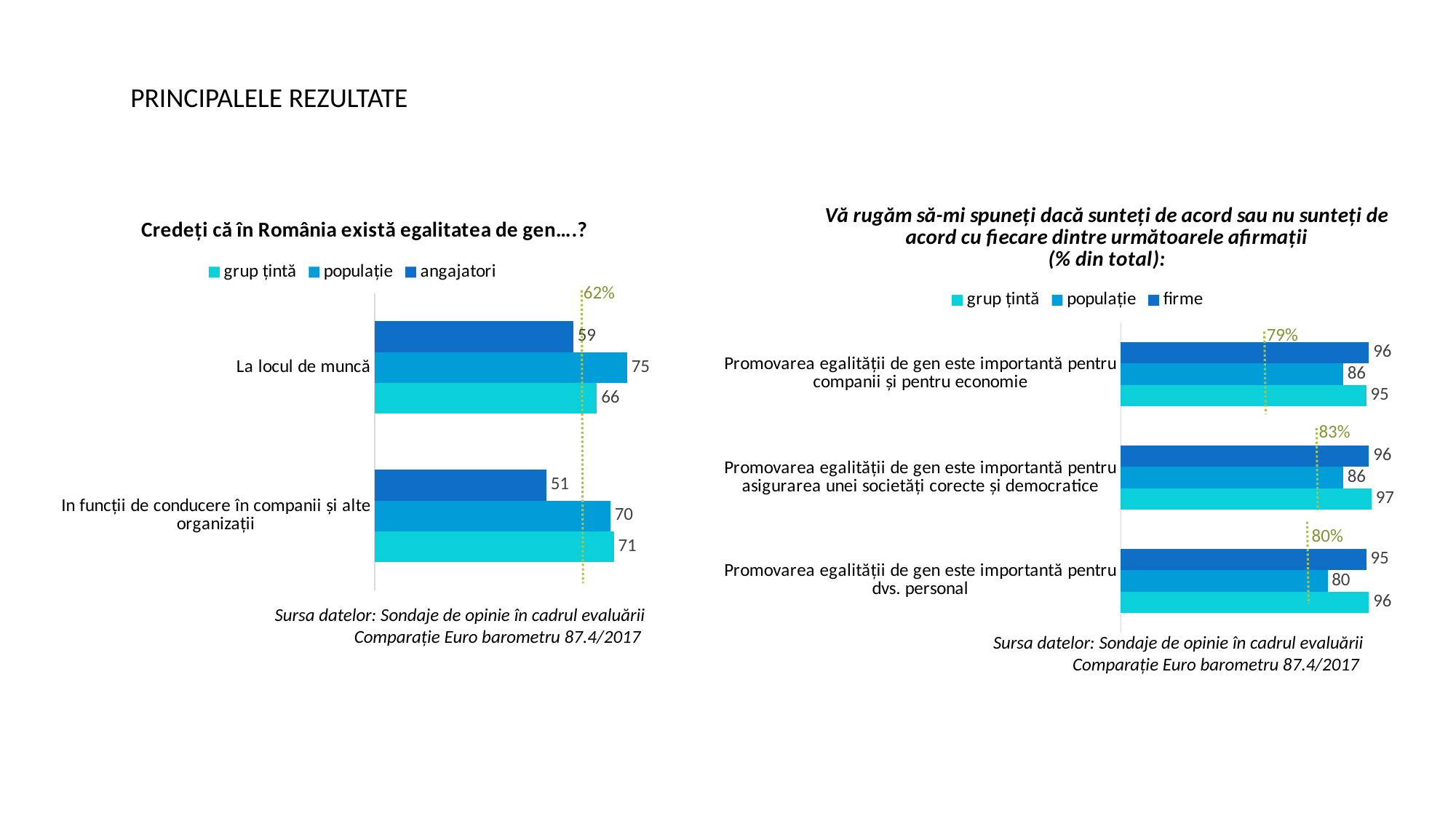
In the right chart (Vă rugăm să-mi spuneți dacă sunteți de acord...), what is the difference between the firme and populație values for 'Promovarea egalității de gen este importantă pentru dvs. personal'? 15 In the right chart (Vă rugăm să-mi spuneți dacă sunteți de acord...), how many statements (categories) are shown? 3 In the left chart (Credeți că în România există egalitatea de gen….?), what is the value for populație for 'La locul de muncă'? 75 In the left chart (Credeți că în România există egalitatea de gen….?), what is the value for angajatori for 'In funcții de conducere în companii și alte organizații'? 51 In the right chart (Vă rugăm să-mi spuneți dacă sunteți de acord...), which series has the lowest value for 'Promovarea egalității de gen este importantă pentru companii și pentru economie'? populație In the right chart (Vă rugăm să-mi spuneți dacă sunteți de acord...), what is the value for grup țintă for 'Promovarea egalității de gen este importantă pentru asigurarea unei societăți corecte și democratice'? 97 In the right chart (Vă rugăm să-mi spuneți dacă sunteți de acord...), what is the value for populație for 'Promovarea egalității de gen este importantă pentru dvs. personal'? 80 In the left chart (Credeți că în România există egalitatea de gen….?), what is the difference between the populație and angajatori values for 'La locul de muncă'? 16 In the left chart (Credeți că în România există egalitatea de gen….?), which series has the lowest value for 'La locul de muncă'? angajatori What type of chart is the right chart (Vă rugăm să-mi spuneți dacă sunteți de acord...)? bar chart In the left chart (Credeți că în România există egalitatea de gen….?), what percentage is marked by the dotted reference line? 62% In the left chart (Credeți că în România există egalitatea de gen….?), how many series does the legend list? 3